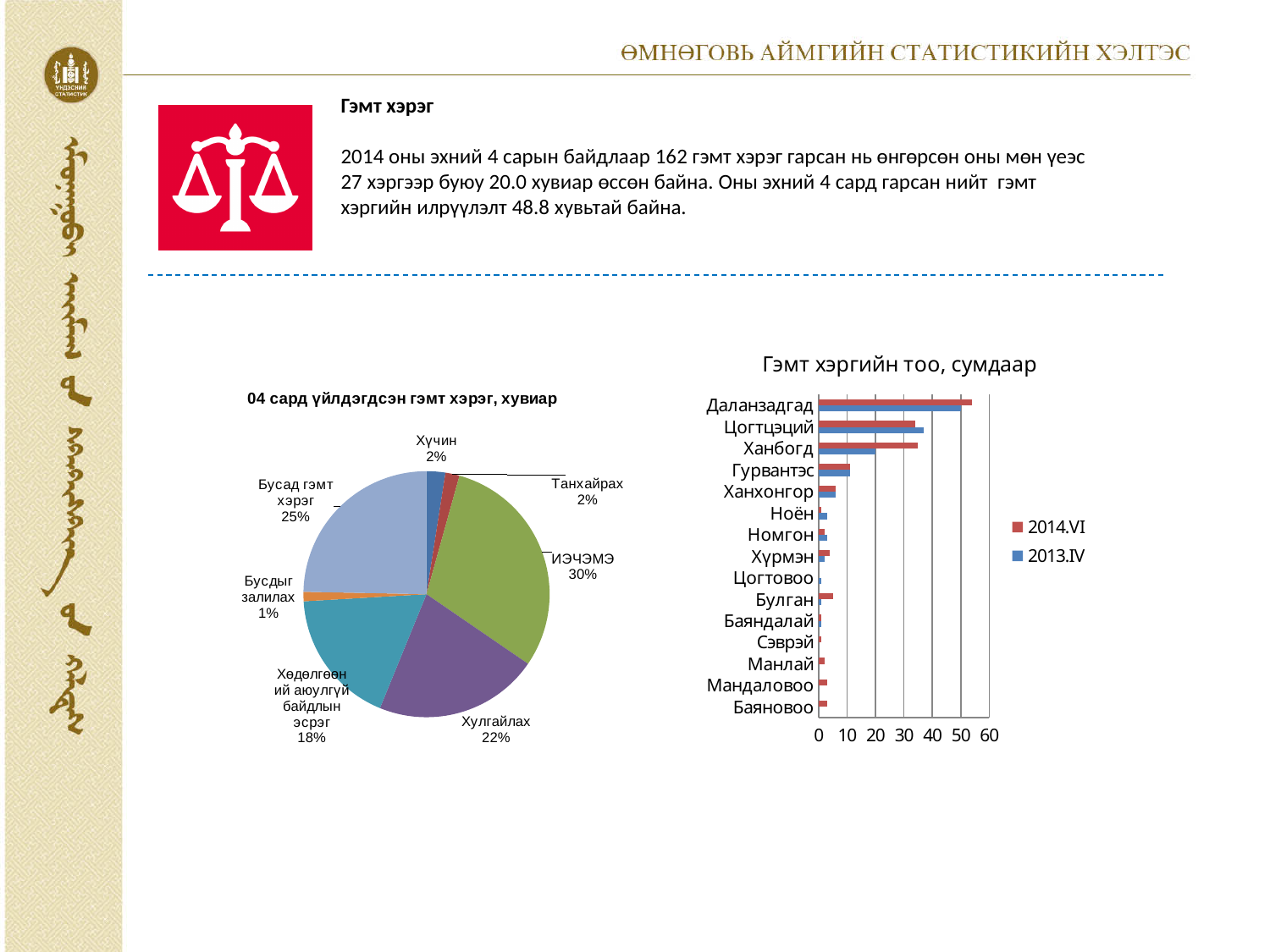
In the pie chart '04 сард үйлдэгдсэн гэмт хэрэг, хувиар', which category has the largest share? ИЭЧЭМЭ In the chart 'Гэмт хэргийн тоо, сумдаар', is the 2014.VI value for Даланзадгад greater or less than 50? greater In the chart 'Гэмт хэргийн тоо, сумдаар', for Ханбогд, which series has the larger value, 2014.VI or 2013.IV? 2014.VI In the pie chart '04 сард үйлдэгдсэн гэмт хэрэг, хувиар', which category has the smallest share? Бусдыг залилах In the pie chart '04 сард үйлдэгдсэн гэмт хэрэг, хувиар', what is the difference in percentage points between ИЭЧЭМЭ and Хөдөлгөөний аюулгүй байдлын эсрэг? 12 How many series does the legend of the chart 'Гэмт хэргийн тоо, сумдаар' list? 2 In the pie chart '04 сард үйлдэгдсэн гэмт хэрэг, хувиар', what share does Бусад гэмт хэрэг have? 25% What type of chart is 'Гэмт хэргийн тоо, сумдаар'? Bar chart How many slices does the pie chart '04 сард үйлдэгдсэн гэмт хэрэг, хувиар' have? 7 In the pie chart '04 сард үйлдэгдсэн гэмт хэрэг, хувиар', what share does Хулгайлах have? 22% How many soums (categories) are shown in the chart 'Гэмт хэргийн тоо, сумдаар'? 15 In the chart 'Гэмт хэргийн тоо, сумдаар', which soum has the highest value for 2014.VI? Даланзадгад